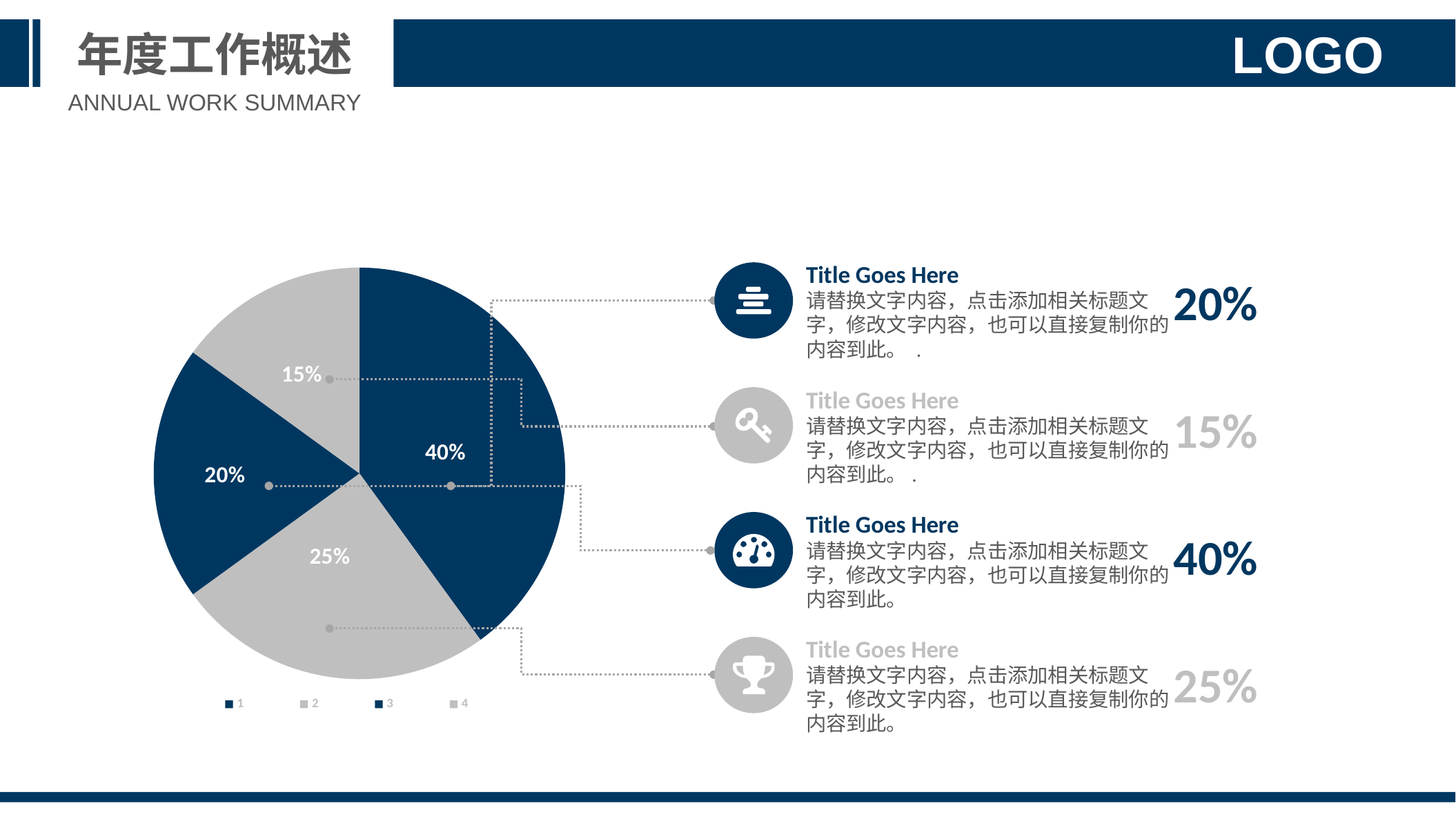
What is the difference between the largest and smallest slices of the pie chart? 25% How many entries does the pie chart's legend list? 4 Which slice of the pie chart is the smallest? 15% How many slices does the pie chart have? 4 Which slice of the pie chart is the largest? 40% What kind of chart is shown on the slide? pie chart What do the four slices of the pie chart add up to? 100% What share of the pie does legend category 1 (the slice starting at the top, going clockwise) represent? 40% What share of the pie does legend category 2 represent? 25% What labels does the pie chart's legend show? 1, 2, 3, 4 Which is larger in the pie chart: the 20% slice or the 25% slice? 25% What share of the pie does legend category 4 represent? 15%